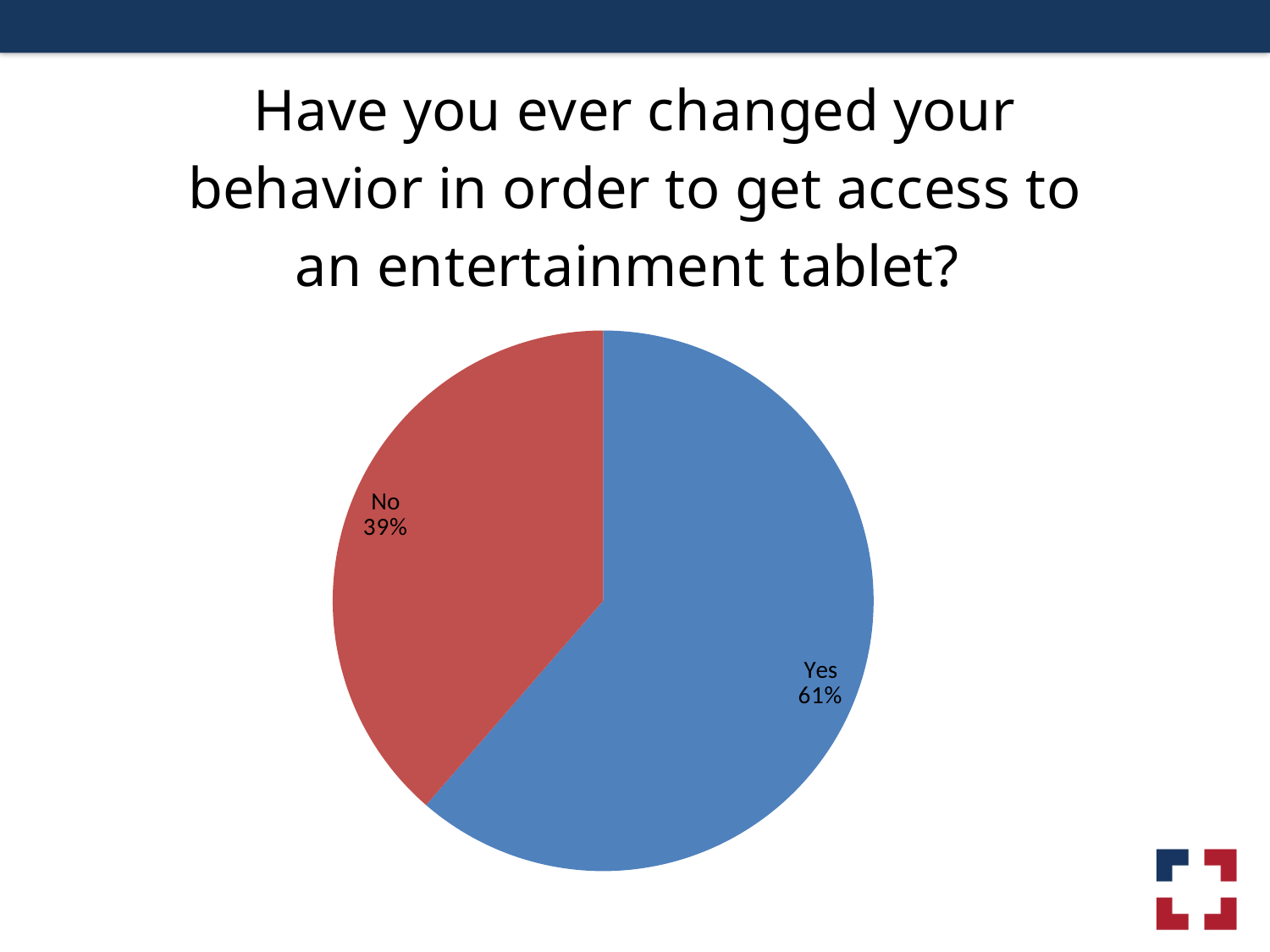
What share of the pie does the No slice represent? 39% What kind of chart is shown on the slide? pie chart Which response has the larger share of the pie? Yes How many slices does the pie chart have? 2 Which response has the smaller share of the pie? No Is the share for Yes larger or smaller than the share for No? larger What is the difference in percentage points between the Yes and No shares? 22 What percentage of respondents answered No? 39% What question does the chart title ask? Have you ever changed your behavior in order to get access to an entertainment tablet? What colour is the Yes slice? blue What percentage of respondents answered Yes? 61%